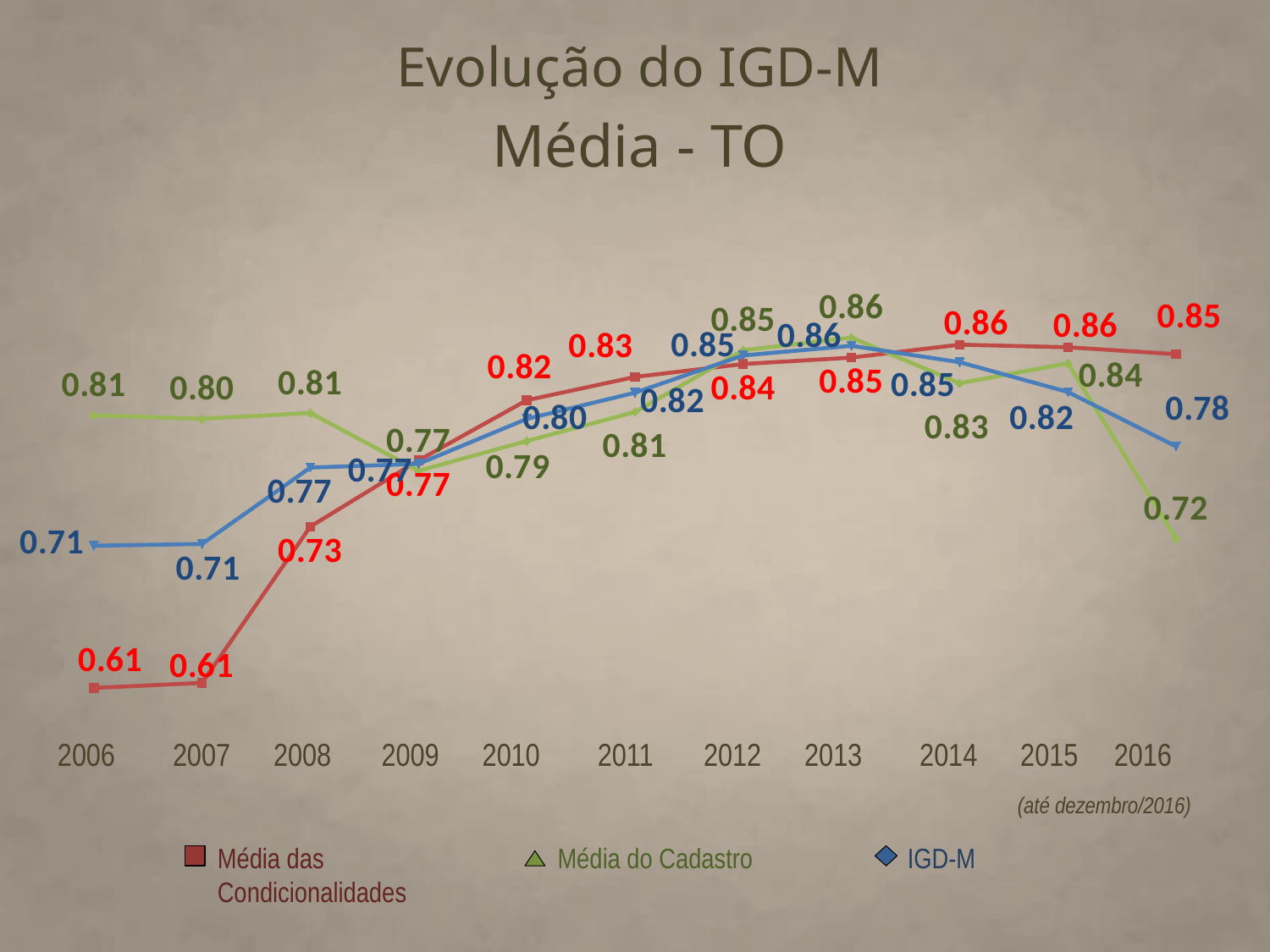
Which is larger in 2016: Média do Cadastro or IGD-M? IGD-M What is the value of IGD-M in 2016? 0.78 Does the Média das Condicionalidades series rise or fall from 2006 to 2014? Rise What is the value of Média do Cadastro in 2010? 0.79 What is the value of Média do Cadastro in 2016? 0.72 In which year is the Média das Condicionalidades series at its lowest? 2006 and 2007 What kind of chart is shown on the slide? Line chart In which year does the IGD-M series reach its highest value? 2013 How many series does the legend list? 3 How many years are shown on the x axis? 11 What is the difference between the Média das Condicionalidades values in 2016 and 2006? 0.24 What is the value of Média das Condicionalidades in 2006? 0.61